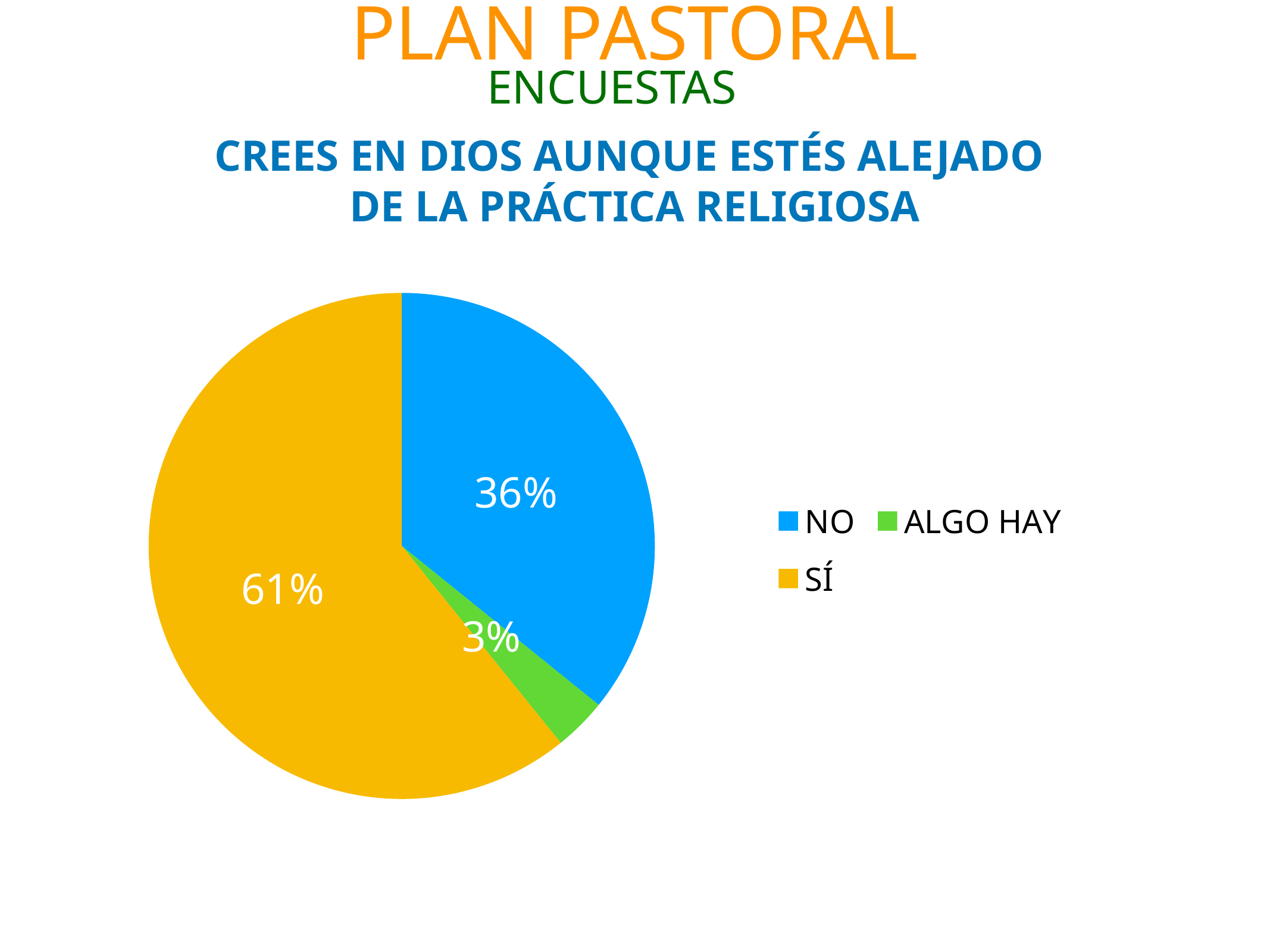
How many slices does the pie chart have? 3 What percentage of the pie chart corresponds to NO? 36% Which category has the largest share of the pie chart? SÍ What is the difference in percentage points between SÍ and NO? 25 Which category has the smallest share of the pie chart? ALGO HAY How many entries does the legend list? 3 What colour is the slice for SÍ? Yellow What kind of chart is shown on the slide? Pie chart Which is larger, the share for NO or the share for ALGO HAY? NO What is the title of the chart? CREES EN DIOS AUNQUE ESTÉS ALEJADO DE LA PRÁCTICA RELIGIOSA What percentage of the pie chart corresponds to ALGO HAY? 3% What percentage of the pie chart corresponds to SÍ? 61%